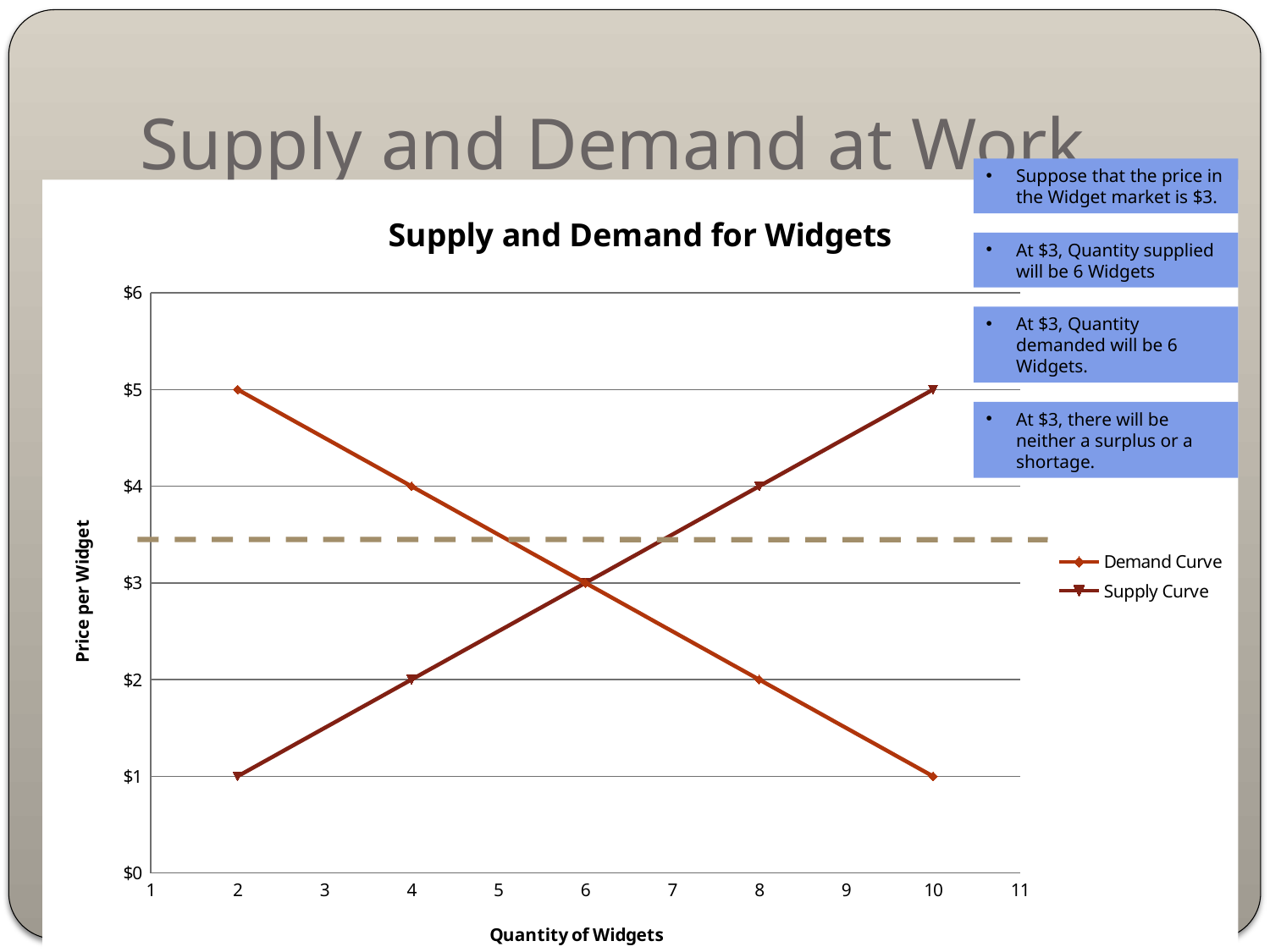
What is the title of the chart? Supply and Demand for Widgets Does the Supply Curve rise or fall as quantity increases along the x axis? Rise What kind of chart is shown on the slide? Line chart What is the price on the Supply Curve at a quantity of 10 widgets? $5 What is the price on the Demand Curve at a quantity of 2 widgets? $5 How many data points are plotted on the Demand Curve? 5 What is the price on the Demand Curve at a quantity of 8 widgets? $2 At a quantity of 4 widgets, which is higher, the Demand Curve or the Supply Curve? Demand Curve What is the difference between the Supply Curve price and the Demand Curve price at a quantity of 8 widgets? $2 At what price do the Demand Curve and Supply Curve intersect? $3 Does the Demand Curve rise or fall as quantity increases along the x axis? Fall How many series does the chart legend list? 2